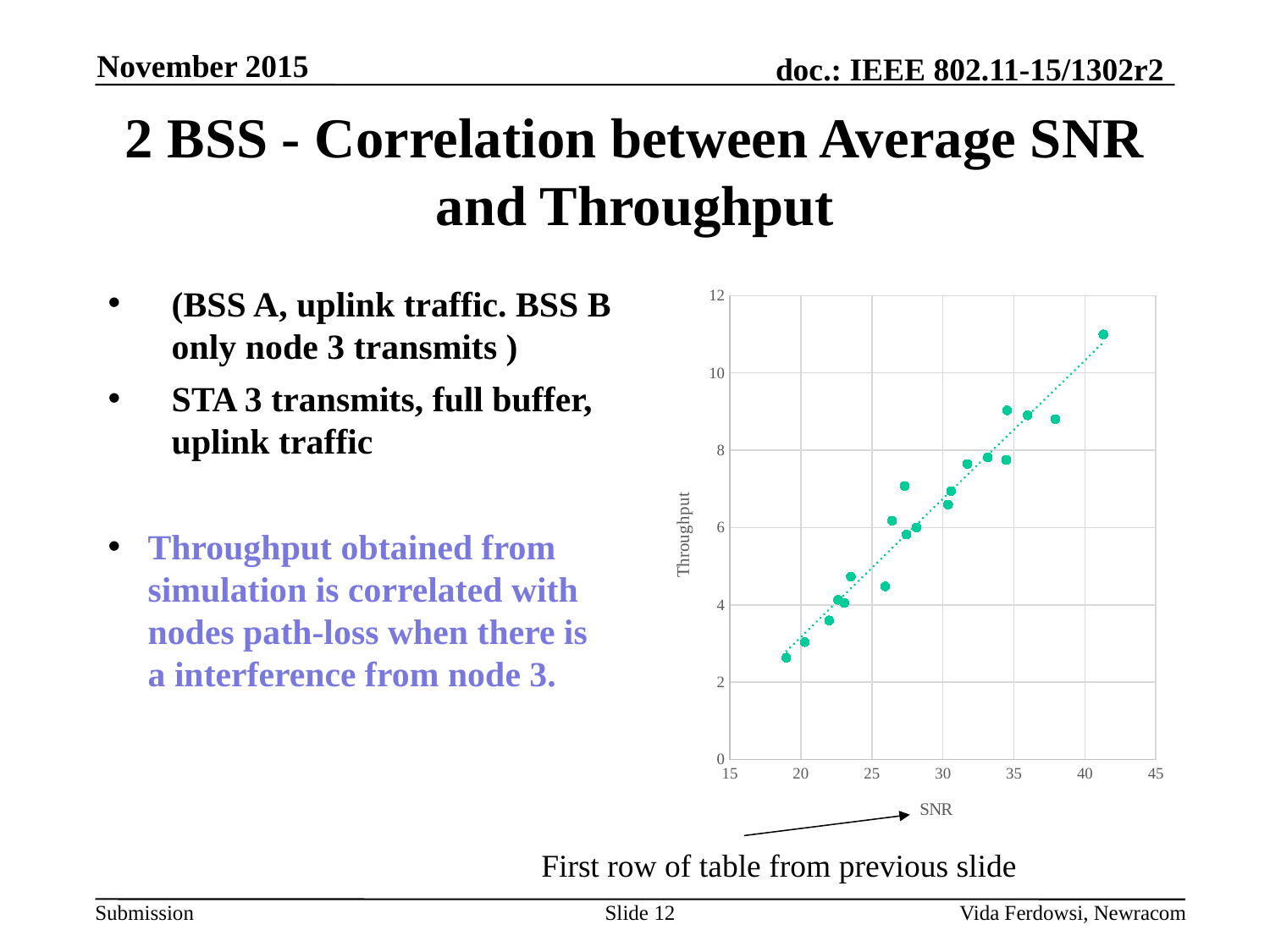
Is the lowest Throughput value plotted greater or less than 4? less As SNR increases along the x axis, does Throughput generally rise or fall? rise Is the Throughput of the point with the highest SNR greater or less than 8? greater What is the label of the y axis of the chart? Throughput What is the maximum value shown on the y axis of the chart? 12 Is the SNR of the rightmost point greater or less than 40? greater What is the label of the x axis of the chart? SNR Which point has the higher Throughput: the one with the lowest SNR or the one with the highest SNR? the one with the highest SNR What kind of chart is shown on the slide? scatter chart